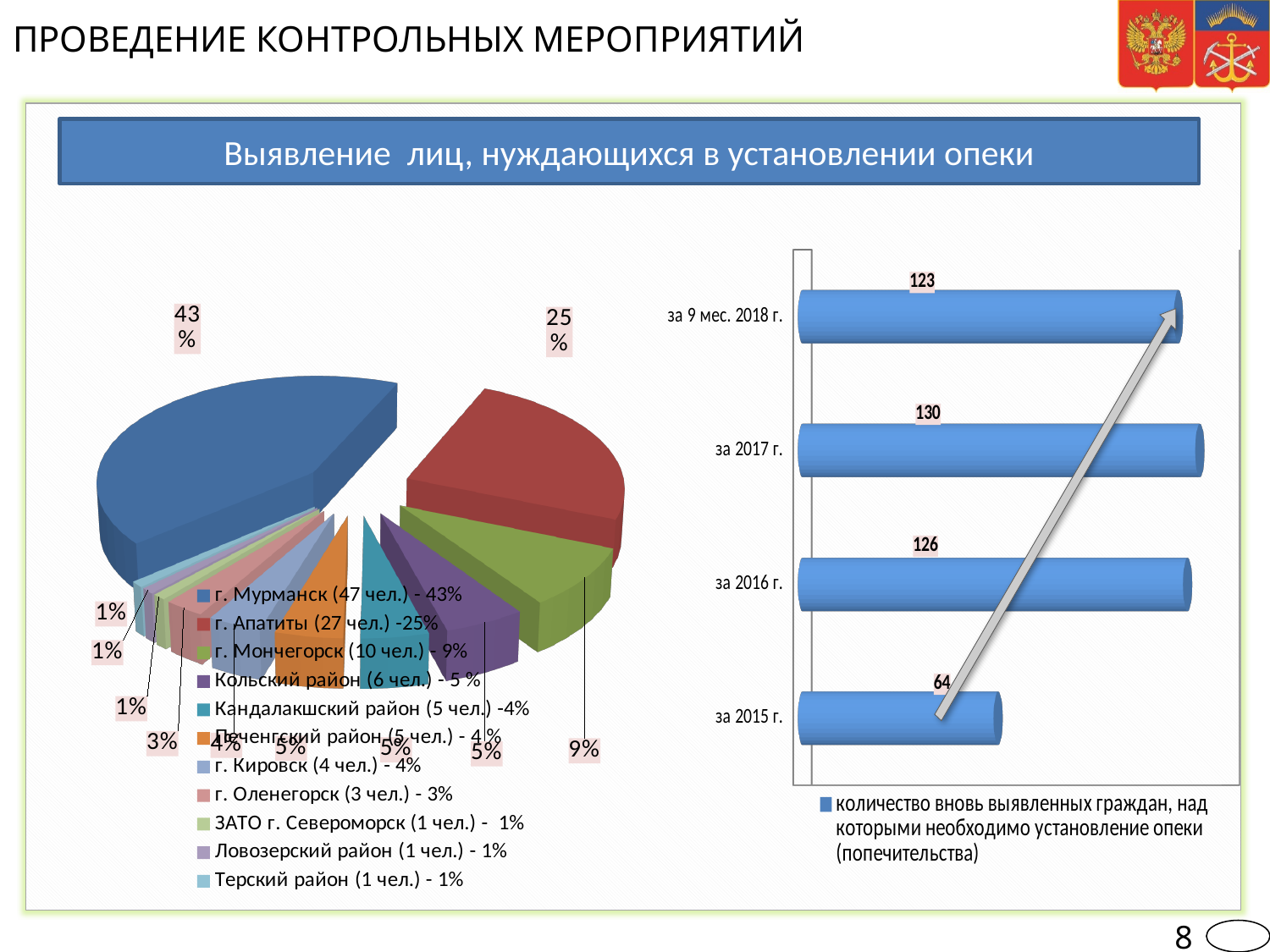
In the bar chart on the right, what is the value for за 2017 г.? 130 How many categories are listed in the legend of the pie chart on the left? 11 What kind of chart is the chart on the right side of the slide? bar chart In the pie chart on the left, what share does г. Мурманск have? 43% In the pie chart on the left, which category has the largest slice? г. Мурманск In the bar chart on the right, what is the difference between the values for за 2017 г. and за 2015 г.? 66 In the bar chart on the right, which period has the highest value? за 2017 г. What kind of chart is the chart on the left side of the slide? pie chart How many bars are shown in the bar chart on the right? 4 In the bar chart on the right, what is the value for за 2015 г.? 64 In the bar chart on the right, which is larger: the value for за 2016 г. or for за 9 мес. 2018 г.? за 2016 г. In the bar chart on the right, which period has the lowest value? за 2015 г.